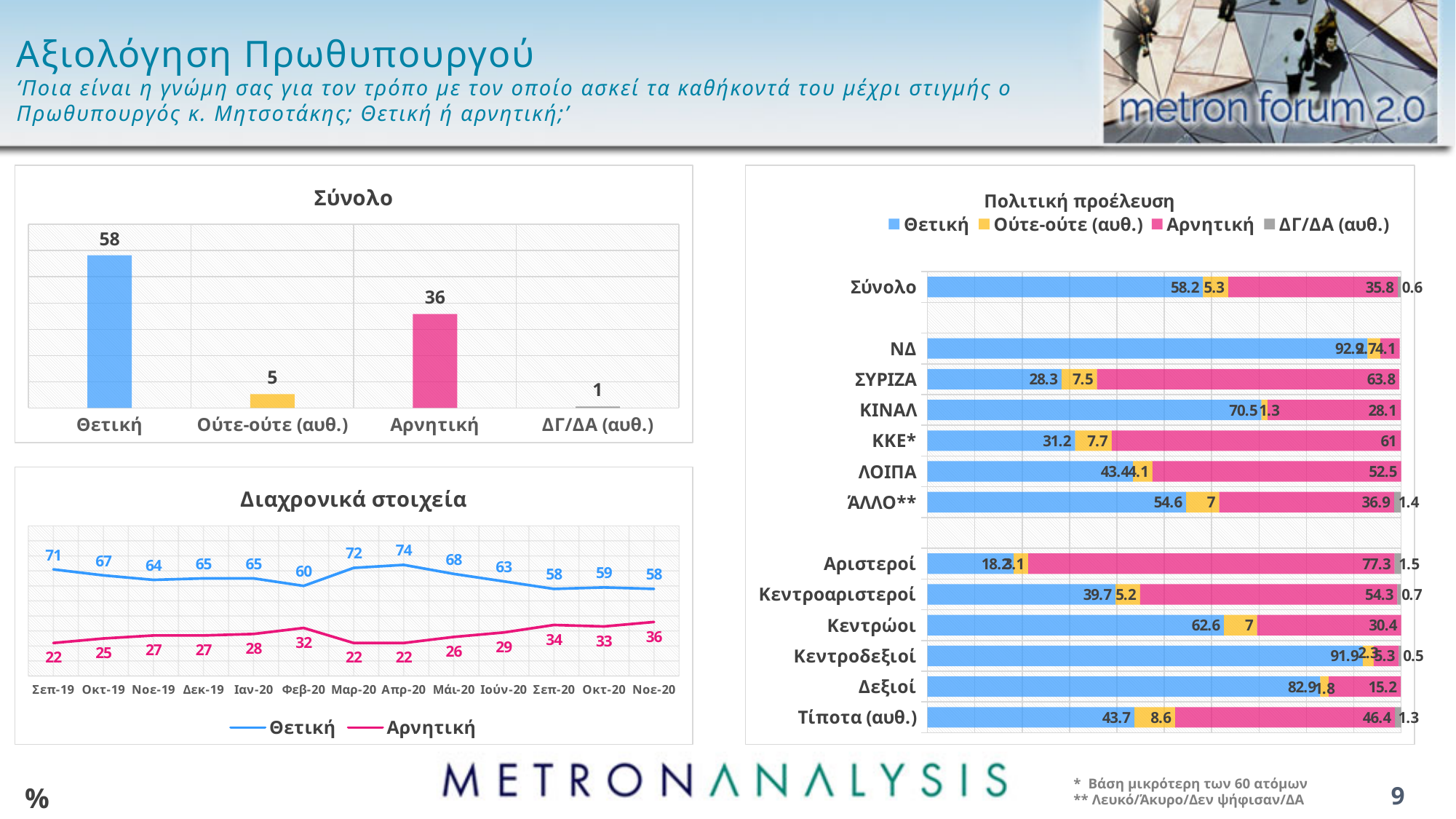
In the 'Διαχρονικά στοιχεία' chart, what is the value of Αρνητική for Νοε-20? 36 In the 'Πολιτική προέλευση' chart, what is the Αρνητική value for ΣΥΡΙΖΑ? 63.8 In the 'Διαχρονικά στοιχεία' chart, does the Αρνητική series rise or fall from Σεπ-20 to Νοε-20 overall? rise In the 'Διαχρονικά στοιχεία' chart, what is the value of Θετική for Απρ-20? 74 How many series does the legend of the 'Πολιτική προέλευση' chart list? 4 In the 'Πολιτική προέλευση' chart, which is larger for Τίποτα (αυθ.): Θετική or Αρνητική? Αρνητική In the 'Σύνολο' chart, what is the difference between Θετική and Αρνητική? 22 In the 'Διαχρονικά στοιχεία' chart, how many time points are plotted on the x axis? 13 What kind of chart is the 'Διαχρονικά στοιχεία' chart? line chart In the 'Σύνολο' chart, which category has the lowest value? ΔΓ/ΔΑ (αυθ.) In the 'Πολιτική προέλευση' chart, what is the difference between the Θετική values for ΚΙΝΑΛ and ΚΚΕ*? 39.3 In the 'Σύνολο' chart, what is the value for Θετική? 58